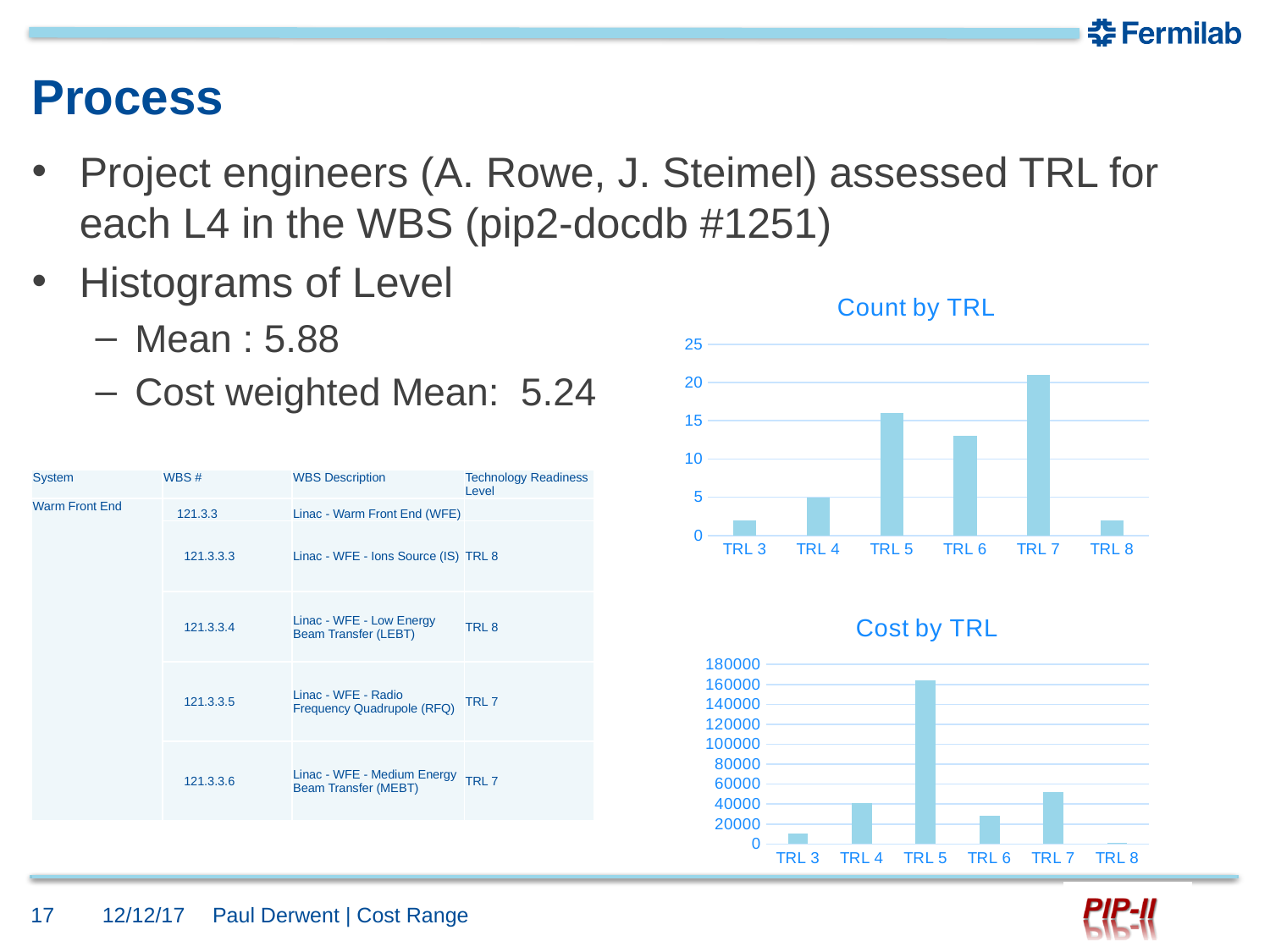
In the "Count by TRL" chart, which TRL has the highest count? TRL 7 In the "Count by TRL" chart, which is larger, the count for TRL 5 or TRL 6? TRL 5 In the "Cost by TRL" chart, which TRL has the lowest cost? TRL 8 What kind of chart is the "Count by TRL" chart? bar chart In the "Count by TRL" chart, how many TRL categories are shown on the x axis? 6 What is the title of the lower chart on the slide? Cost by TRL In the "Cost by TRL" chart, which TRL has the highest cost? TRL 5 In the "Count by TRL" chart, is the value for TRL 5 greater or less than 15? greater In the "Cost by TRL" chart, which is larger, the cost for TRL 7 or TRL 6? TRL 7 In the "Count by TRL" chart, is the value for TRL 6 greater or less than 15? less In the "Count by TRL" chart, is the value for TRL 7 greater or less than 20? greater